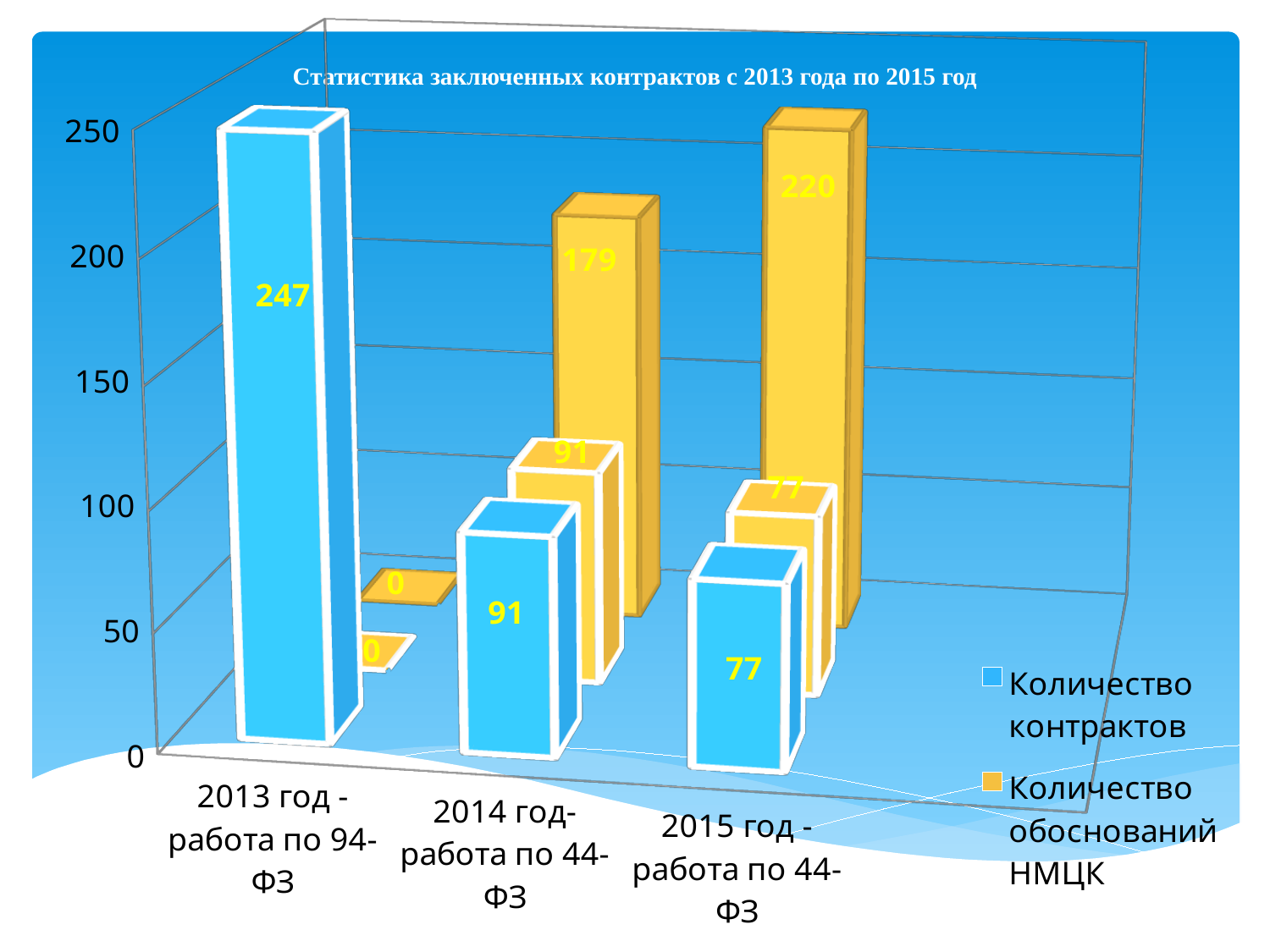
Does Количество контрактов rise or fall from 2013 to 2015? fall What kind of chart is shown on the slide? bar chart What is the value of Количество контрактов for 2015 год - работа по 44-ФЗ? 77 What is the value of Количество контрактов for 2014 год- работа по 44-ФЗ? 91 What is the value of Количество контрактов for 2013 год - работа по 94-ФЗ? 247 What is the title of the chart? Статистика заключенных контрактов с 2013 года по 2015 год Which category has the lowest value for Количество контрактов? 2015 год - работа по 44-ФЗ What is the difference between Количество контрактов in 2013 and in 2014? 156 Which category has the highest value for Количество контрактов? 2013 год - работа по 94-ФЗ How many categories are shown on the x axis? 3 How many series does the legend list? 2 What is the value labelled on the tallest yellow bar in the chart? 220